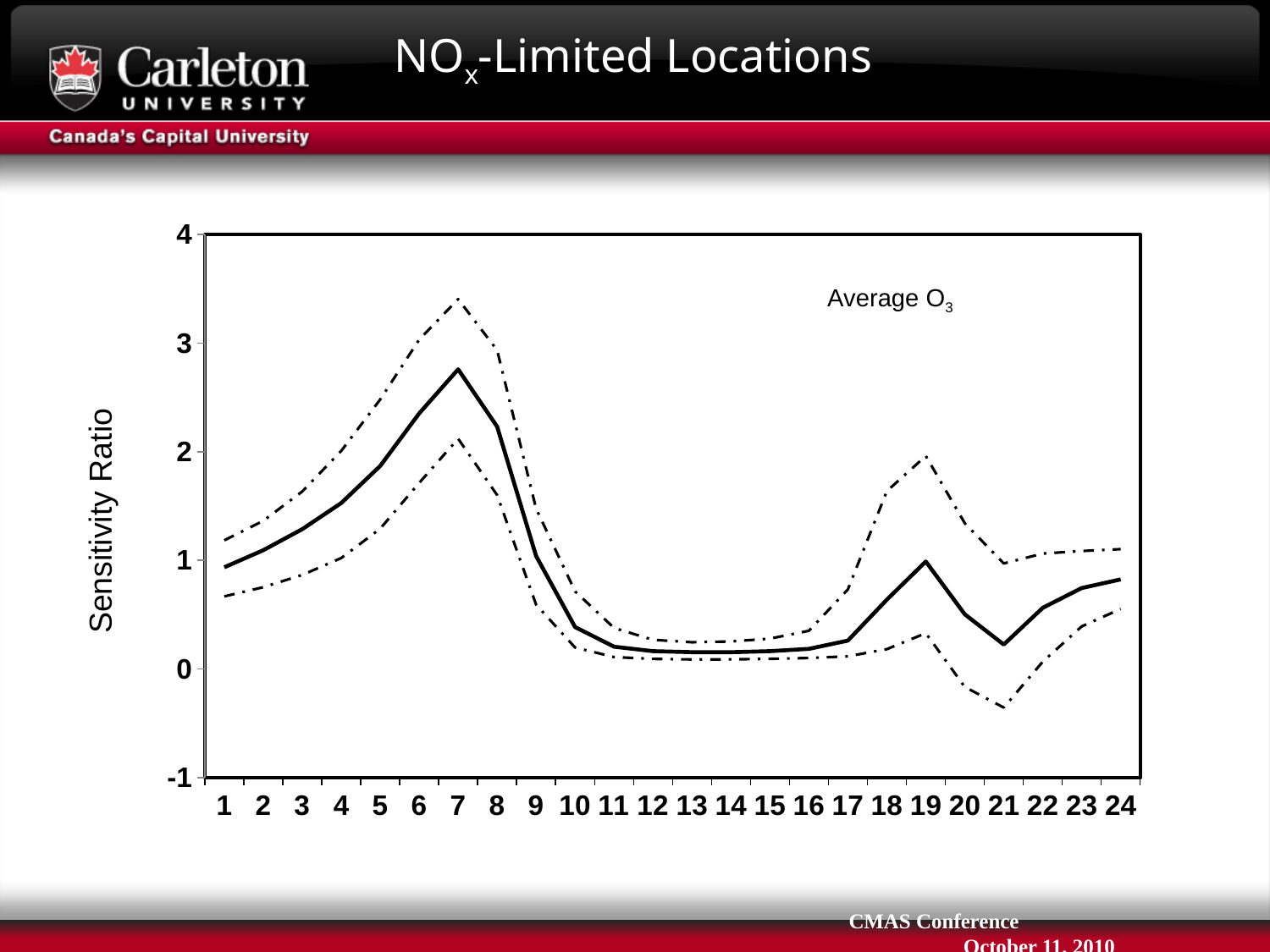
Is the value of the lower dash-dot line at x = 21 greater or less than 0? less At which x-axis value does the lower dash-dot line reach its lowest point? 21 Is the value of the solid line at x = 13 greater or less than 1? less How many points are labelled along the x axis of the chart? 24 Is the value of the upper dash-dot line at x = 7 greater or less than 3? greater What is the text annotation shown inside the plot area of the chart? Average O3 Which is larger for the solid line: the value at x = 7 or the value at x = 19? x = 7 What is the label on the y axis of the chart? Sensitivity Ratio What kind of chart is shown on the slide? line chart Does the solid line rise or fall between x = 7 and x = 10? fall At which x-axis value does the solid line reach its highest point? 7